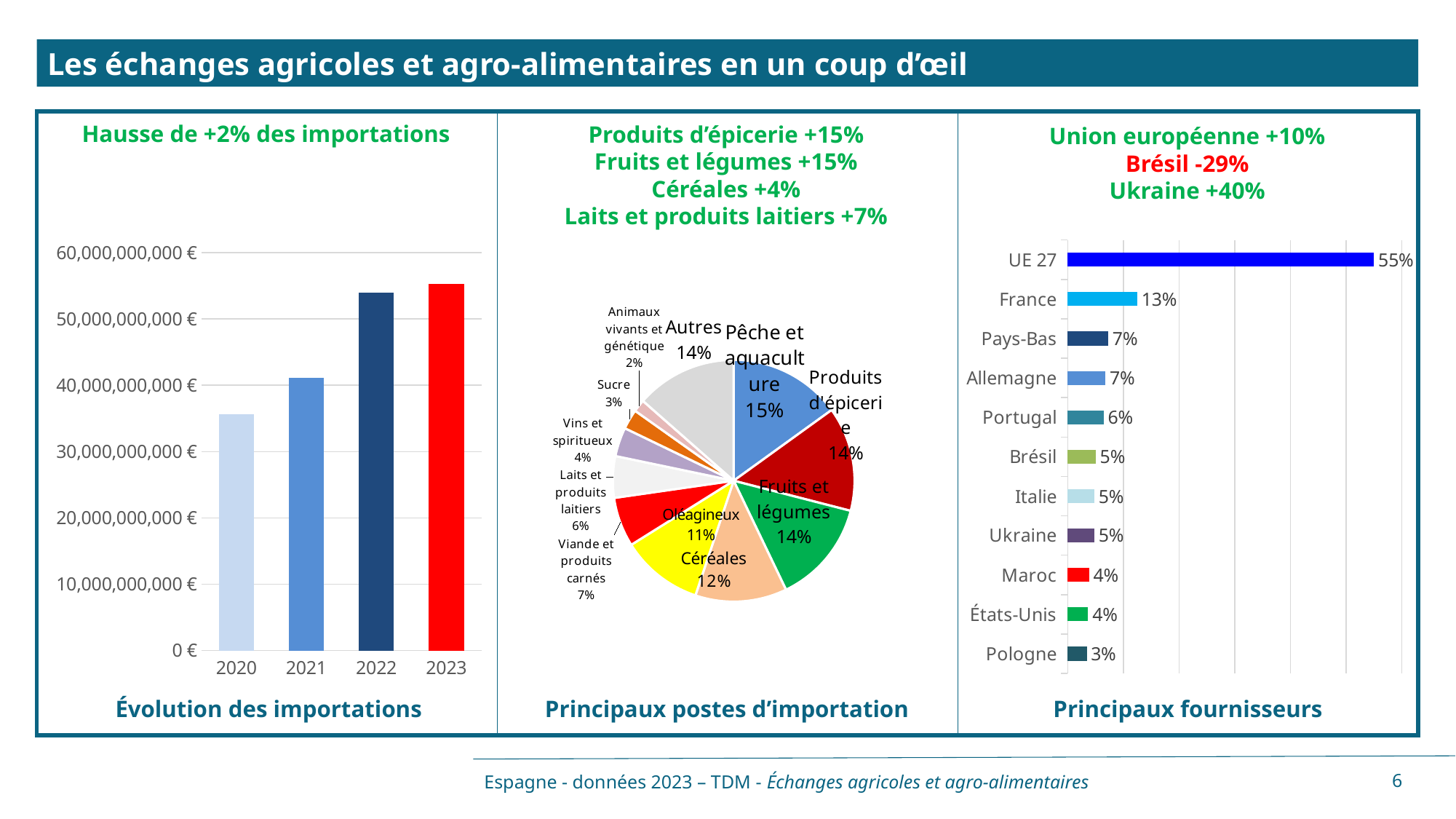
In the 'Principaux postes d'importation' pie chart, what is the share of Sucre? 3% In the 'Évolution des importations' chart, which year has the lowest value? 2020 In the 'Évolution des importations' chart, is the value for 2022 greater or less than 50,000,000,000 €? greater What kind of chart is 'Principaux postes d'importation'? pie chart How many years are shown in the 'Évolution des importations' chart? 4 In the 'Principaux postes d'importation' pie chart, what share does Céréales have? 12% In the 'Principaux fournisseurs' chart, what is the difference between UE 27 and France? 42% In the 'Principaux fournisseurs' chart, what is the value for France? 13% In the 'Principaux fournisseurs' chart, which is larger, Portugal or Maroc? Portugal In the 'Principaux fournisseurs' chart, which supplier has the highest value? UE 27 In the 'Évolution des importations' chart, do the values rise or fall from 2020 to 2023? rise In the 'Évolution des importations' chart, is the value for 2020 greater or less than 40,000,000,000 €? less